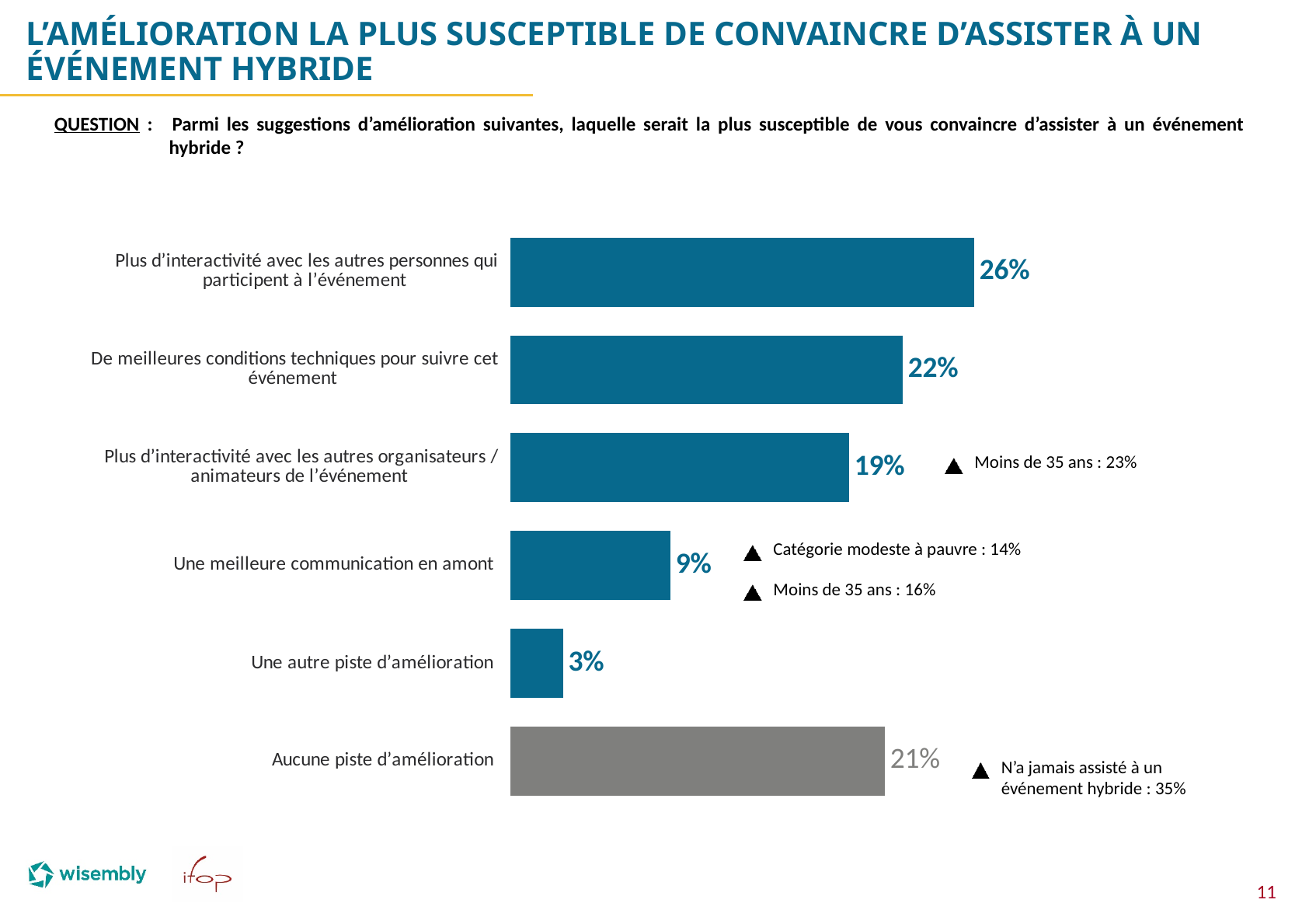
What is the value for "De meilleures conditions techniques pour suivre cet événement"? 22% What is the difference between the values for "Plus d'interactivité avec les autres personnes qui participent à l'événement" and "De meilleures conditions techniques pour suivre cet événement"? 4% What kind of chart is shown on the slide? Bar chart Which category has the highest value? Plus d'interactivité avec les autres personnes qui participent à l'événement Which category has the lowest value? Une autre piste d'amélioration Which is larger: the value for "Plus d'interactivité avec les autres organisateurs / animateurs de l'événement" or the value for "Aucune piste d'amélioration"? Aucune piste d'amélioration What is the difference between the values for "Une meilleure communication en amont" and "Une autre piste d'amélioration"? 6% Which bar is shown in grey rather than blue? Aucune piste d'amélioration What is the value for "Plus d'interactivité avec les autres personnes qui participent à l'événement"? 26% How many categories are shown in the chart? 6 What is the value for "Aucune piste d'amélioration"? 21% What is the value for "Une meilleure communication en amont"? 9%